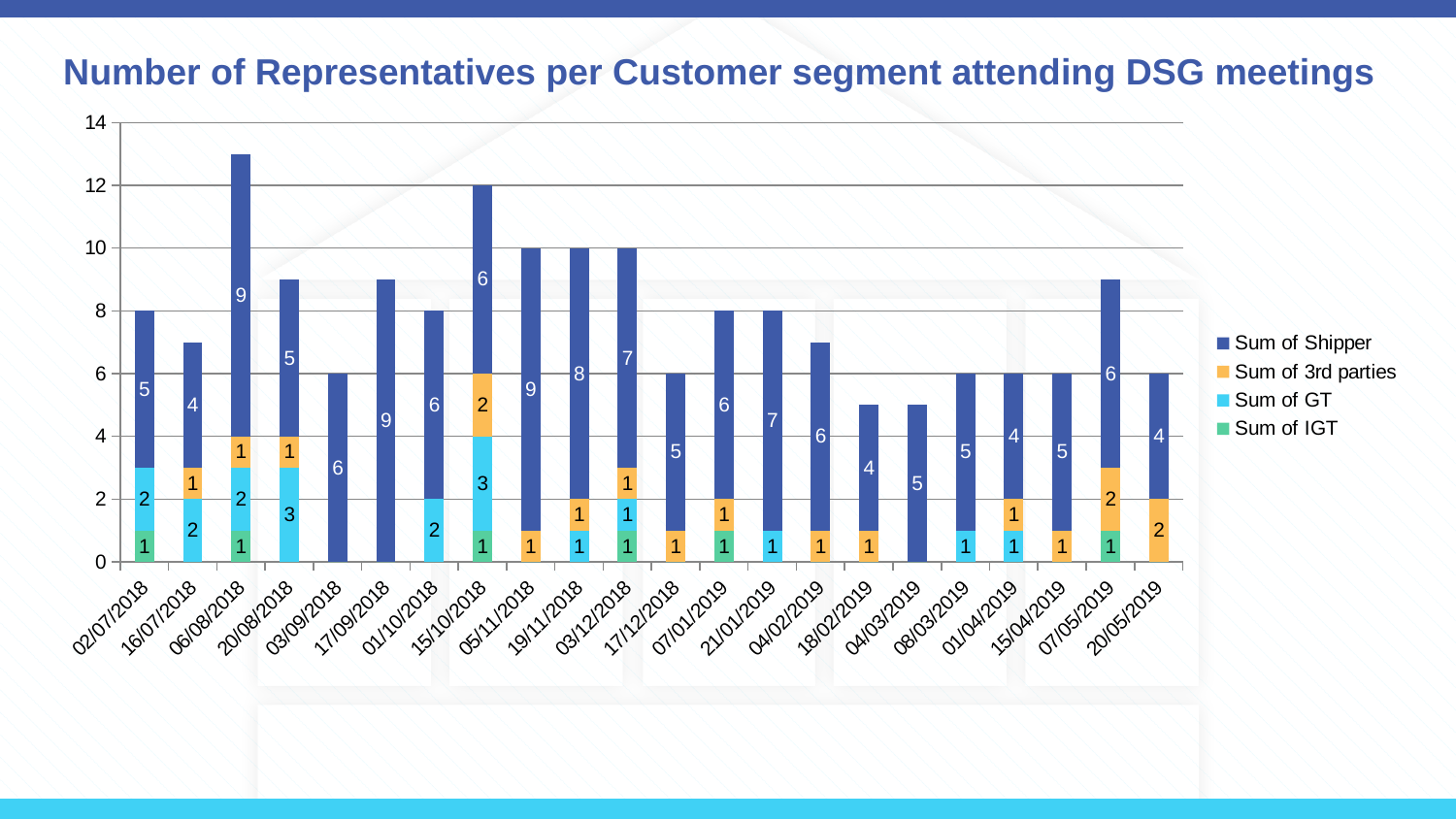
Is the total for 03/09/2018 greater or less than 8? less Which meeting date has the highest total number of representatives? 06/08/2018 How many series does the legend list? 4 What is the difference between the Sum of Shipper values for 17/09/2018 and 18/02/2019? 5 What is the total number of representatives for 02/07/2018? 8 How many meeting dates are shown on the x axis? 22 What is the Sum of Shipper value for 06/08/2018? 9 What is the Sum of GT value for 20/08/2018? 3 What kind of chart is shown on the slide? Stacked bar chart What is the Sum of 3rd parties value for 15/10/2018? 2 What is the total number of representatives for 15/10/2018? 12 Which is larger, the Sum of Shipper value for 19/11/2018 or for 20/05/2019? 19/11/2018